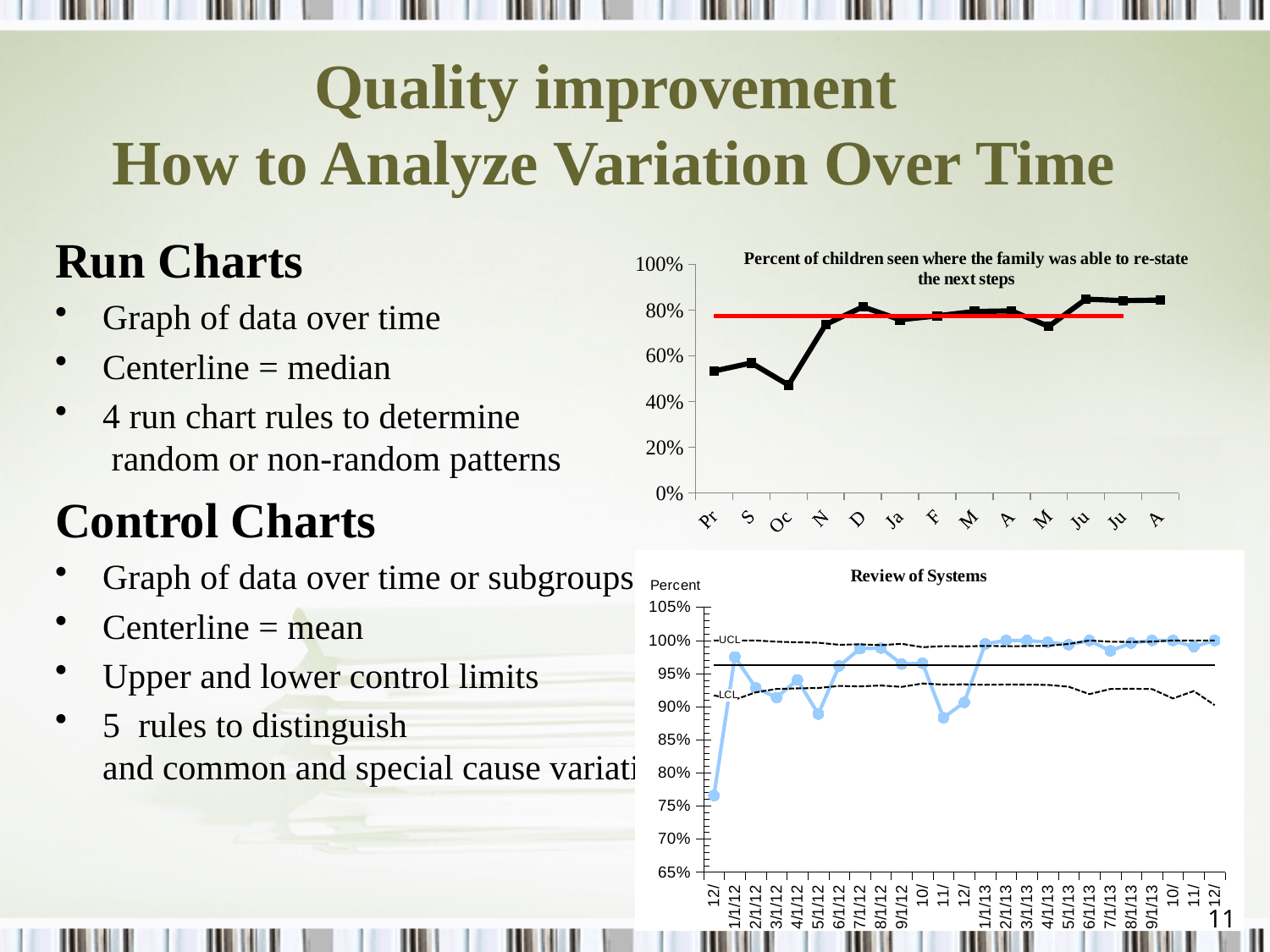
In the 'Percent of children seen where the family was able to re-state the next steps' chart, what colour is the horizontal centerline? red In the 'Percent of children seen where the family was able to re-state the next steps' chart, do the values overall rise or fall from the first point to the last? rise In the 'Percent of children seen where the family was able to re-state the next steps' chart, how many data points are plotted? 13 In the 'Review of Systems' chart, what label is shown on the y axis? Percent What type of chart is the 'Percent of children seen where the family was able to re-state the next steps' chart? line chart In the 'Percent of children seen where the family was able to re-state the next steps' chart, is the value for Oc greater or less than 60%? less In the 'Percent of children seen where the family was able to re-state the next steps' chart, which is larger, the value for Oc or the value for D? D In the 'Review of Systems' chart, which is larger, the value for 5/1/12 or the value for 7/1/12? 7/1/12 In the 'Review of Systems' chart, is the value of the first plotted point greater or less than 80%? less In the 'Percent of children seen where the family was able to re-state the next steps' chart, is the value for N greater or less than 60%? greater What type of chart is the 'Review of Systems' chart? line chart In the 'Percent of children seen where the family was able to re-state the next steps' chart, which x-axis category has the lowest value? Oc